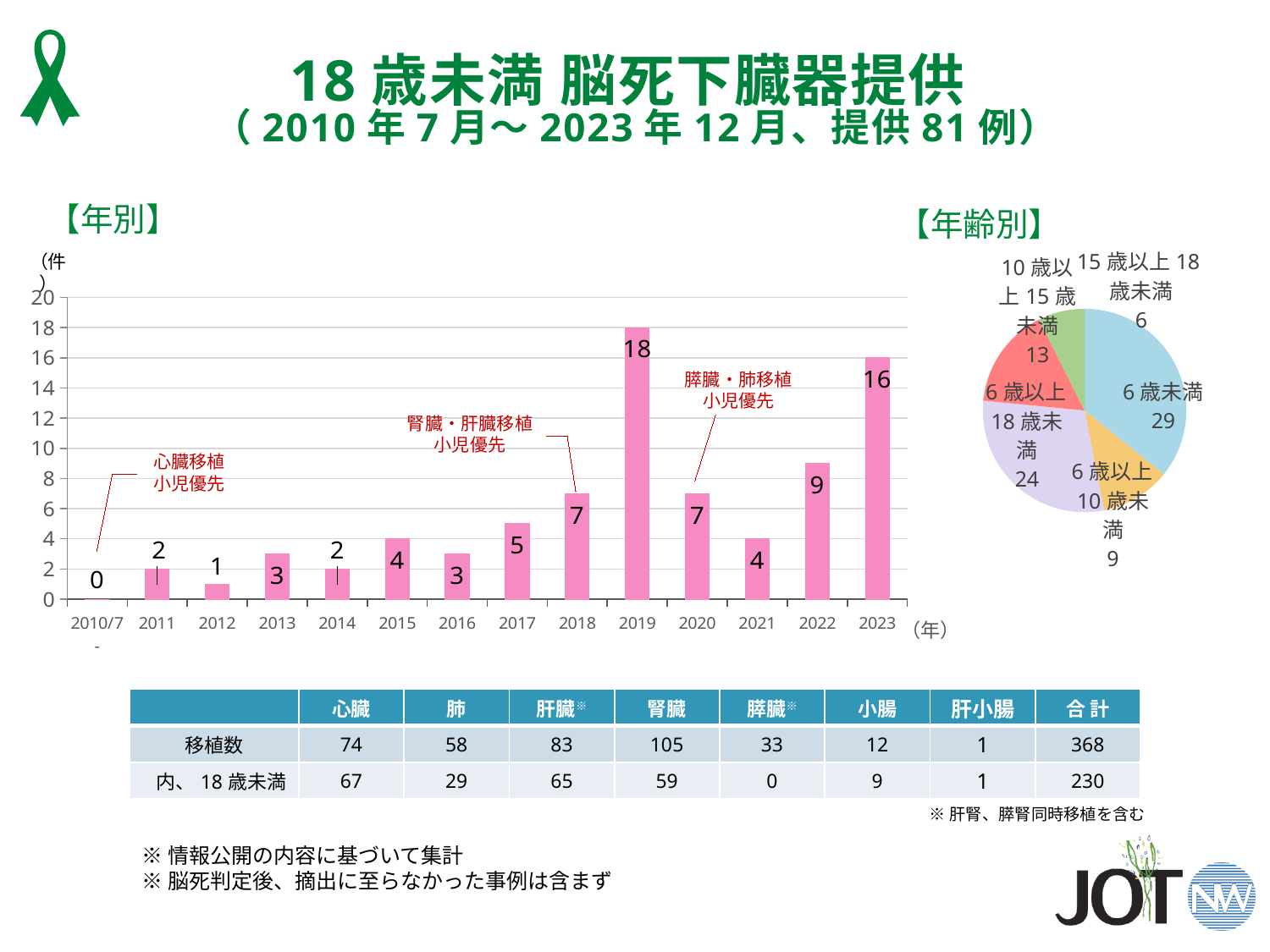
In the 【年別】 bar chart, what is the value for 2019? 18 In the 【年別】 bar chart, what is the difference between the values for 2019 and 2023? 2 In the 【年別】 bar chart, what is the value for 2023? 16 In the 【年齢別】 pie chart, what is the value for 6歳未満? 29 In the 【年齢別】 pie chart, which category has the smallest value? 15歳以上18歳未満 What kind of chart is the 【年別】 chart? bar chart What kind of chart is the 【年齢別】 chart? pie chart In the 【年別】 bar chart, how many years (categories) are shown on the x axis? 14 In the 【年別】 bar chart, which year has the highest value? 2019 In the 【年別】 bar chart, what is the value for 2012? 1 In the 【年齢別】 pie chart, what is the difference between the values for 6歳未満 and 10歳以上15歳未満? 16 In the 【年別】 bar chart, which is larger, the value for 2022 or the value for 2021? 2022